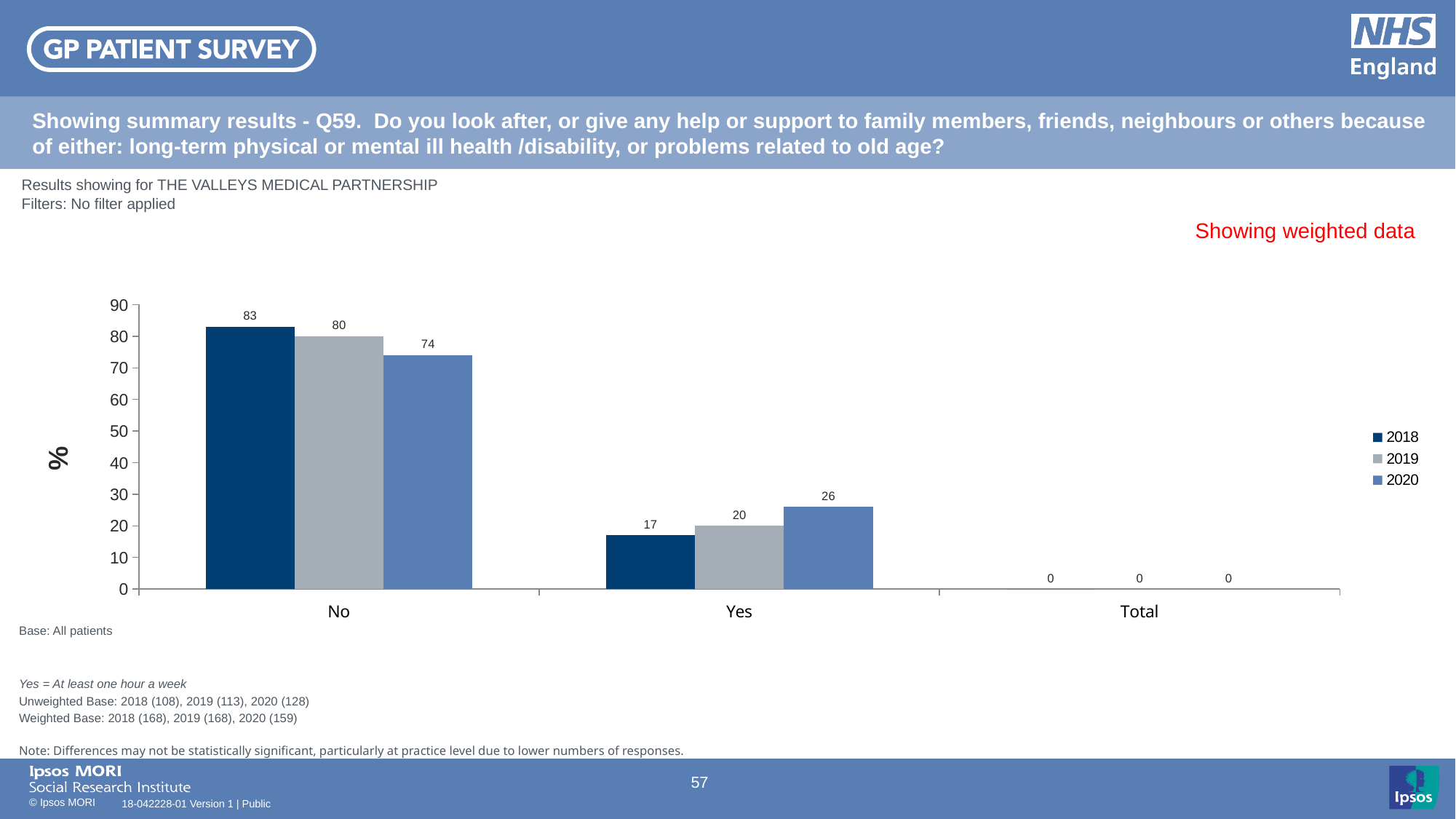
What is the value for 'No' in 2019? 80 What is the value for 'Yes' in 2020? 26 What is the difference between the 'No' values for 2018 and 2020? 9 What is the value for 'No' in 2018? 83 Which year has the highest value for 'Yes'? 2020 Do the 'Yes' values rise or fall from 2018 to 2020? Rise How many series does the legend list? 3 What kind of chart is shown on the slide? Bar chart Which year has the lowest value for 'No'? 2020 How many categories are shown on the x axis? 3 Which is larger: the 'Yes' value for 2019 or the 'Yes' value for 2018? 2019 What is the difference between the 'Yes' values for 2020 and 2018? 9